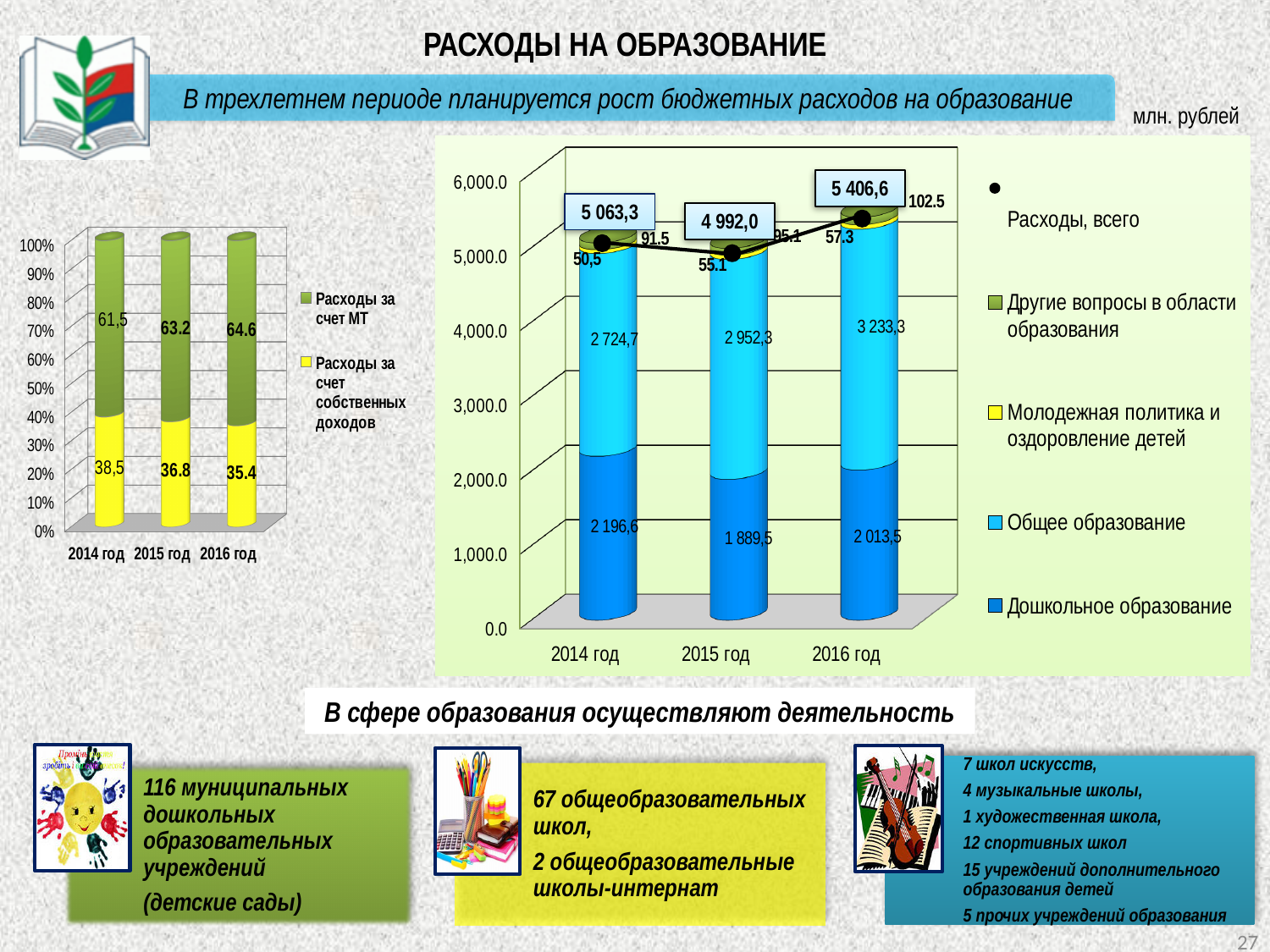
On the right chart, does 'Общее образование' rise or fall from 2014 год to 2016 год? rise On the right chart, how many series does the legend list? 5 On the right chart, which year has the lowest value of 'Расходы, всего'? 2015 год On the left chart, what is the value of 'Расходы за счет собственных доходов' for 2016 год? 35.4 On the left chart, what is the value of 'Расходы за счет МТ' for 2014 год? 61,5 On the left chart, how many years are shown on the x axis? 3 On the right chart, what is the value of 'Общее образование' for 2015 год? 2 952,3 On the right chart, is the value of 'Общее образование' for 2014 год larger or smaller than for 2016 год? smaller On the right chart, what is the value of 'Дошкольное образование' for 2014 год? 2 196,6 On the right chart, what is the value of 'Расходы, всего' for 2016 год? 5 406,6 On the right chart, which year has the highest value of 'Общее образование'? 2016 год What kind of chart is the left chart? bar chart